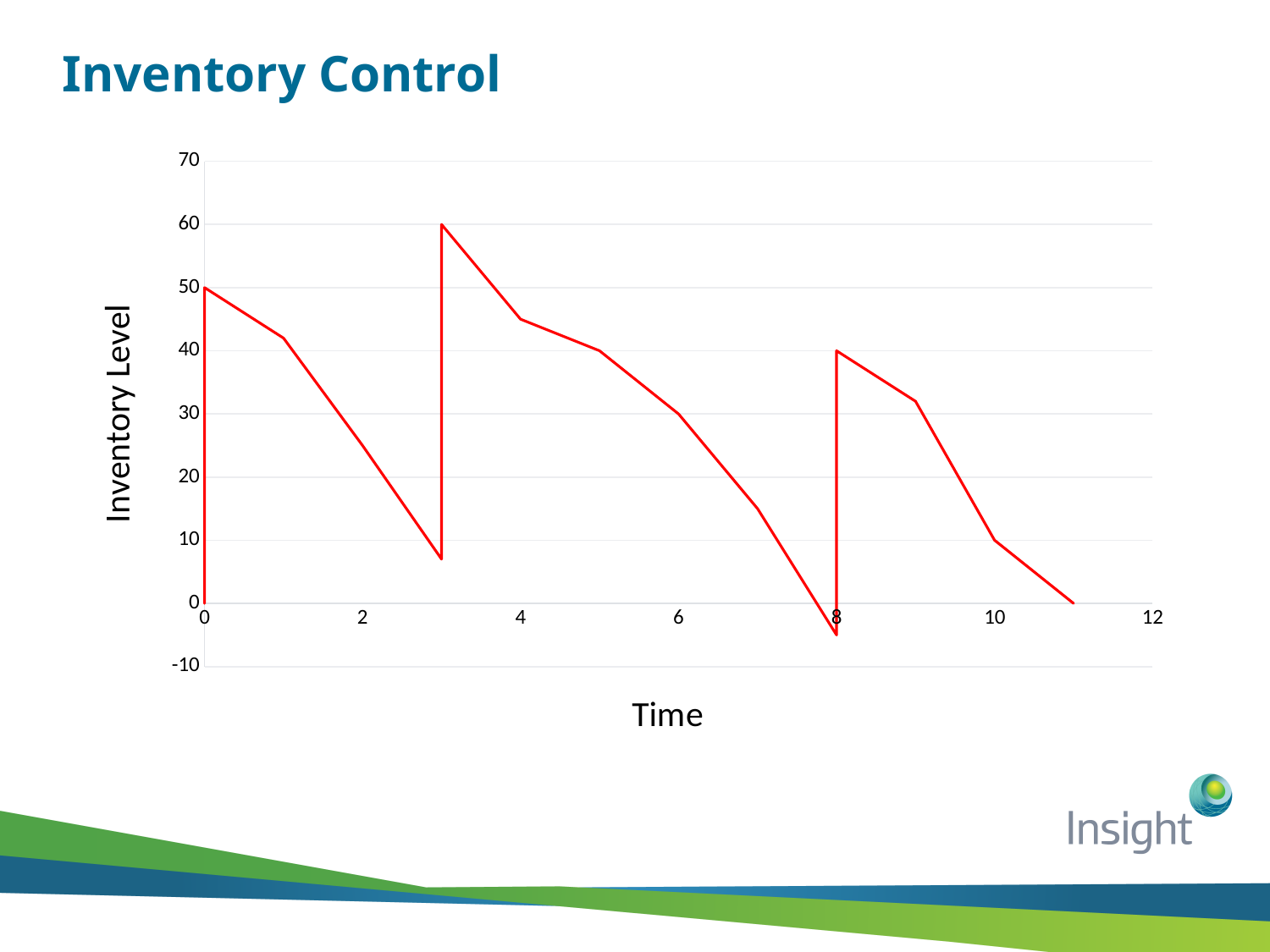
Between time 3 and time 8, does the inventory level rise or fall? fall Is the inventory level at time 2 greater or less than 30? less Is the lowest inventory level on the chart greater or less than 0? less What is the inventory level at time 11? 0 What is the highest inventory level reached on the chart? 60 At what time does the inventory level reach its peak of 60? 3 What is the inventory level at time 6? 30 What is the label of the vertical axis? Inventory Level What is the title of the chart on the slide? Inventory Control What kind of chart is shown on the slide? line chart Is the inventory level at time 4 greater or less than 40? greater